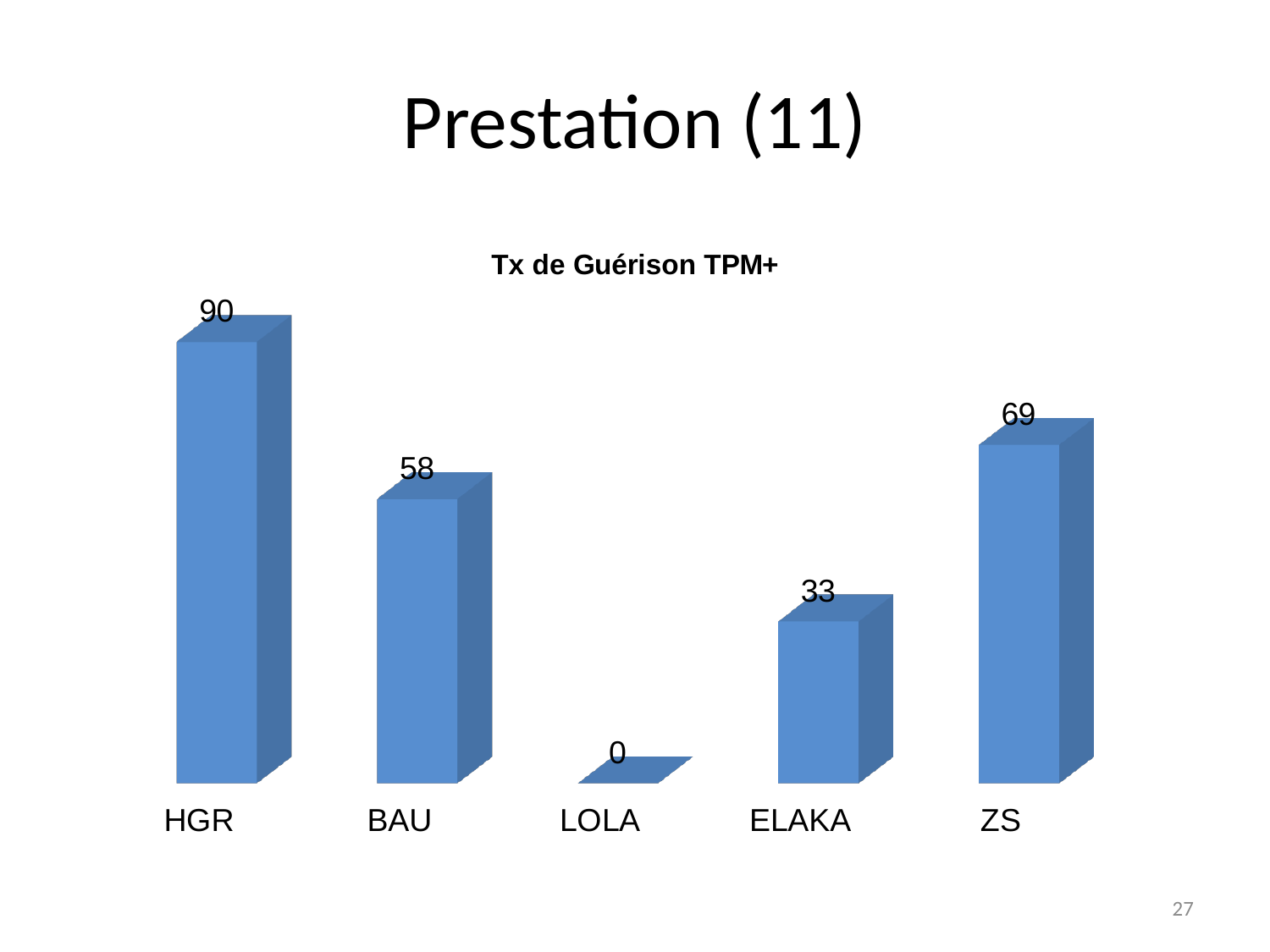
What is the value for ELAKA? 33 What is the title of the chart? Tx de Guérison TPM+ What is the difference between the values for HGR and ZS? 21 Which category has the lowest value? LOLA Which category has the highest value? HGR What is the value for LOLA? 0 What is the value for HGR? 90 Which is larger, the value for BAU or the value for ZS? ZS What is the value for ZS? 69 How many categories are shown on the x axis? 5 What kind of chart is shown? bar chart What is the value for BAU? 58